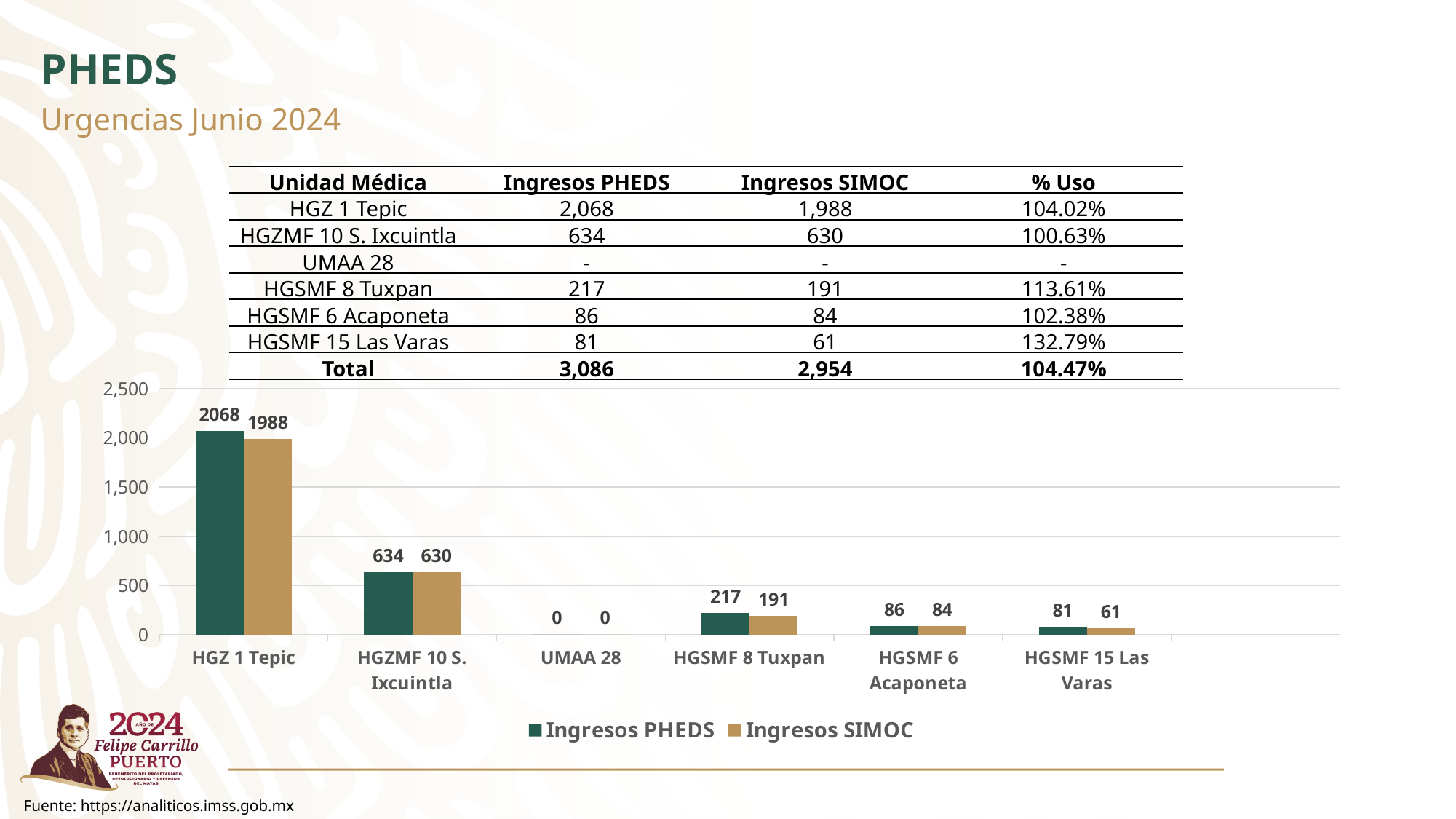
What is the difference between Ingresos PHEDS and Ingresos SIMOC for HGSMF 15 Las Varas in the chart? 20 Which medical unit has the lowest Ingresos SIMOC value in the chart, excluding UMAA 28 which shows 0? HGSMF 15 Las Varas Which colour represents Ingresos SIMOC in the chart? Tan/gold How many series does the chart legend list? 2 Which is larger for HGSMF 8 Tuxpan in the chart: Ingresos PHEDS or Ingresos SIMOC? Ingresos PHEDS What is the Ingresos SIMOC value for HGSMF 8 Tuxpan in the chart? 191 What kind of chart is shown on the slide? Bar chart What is the Ingresos PHEDS value for HGZ 1 Tepic in the chart? 2068 Which medical unit has the highest Ingresos PHEDS value in the chart? HGZ 1 Tepic What is the difference between Ingresos PHEDS and Ingresos SIMOC for HGZ 1 Tepic in the chart? 80 How many medical units are shown on the x axis of the chart? 6 What is the Ingresos SIMOC value for HGSMF 15 Las Varas in the chart? 61